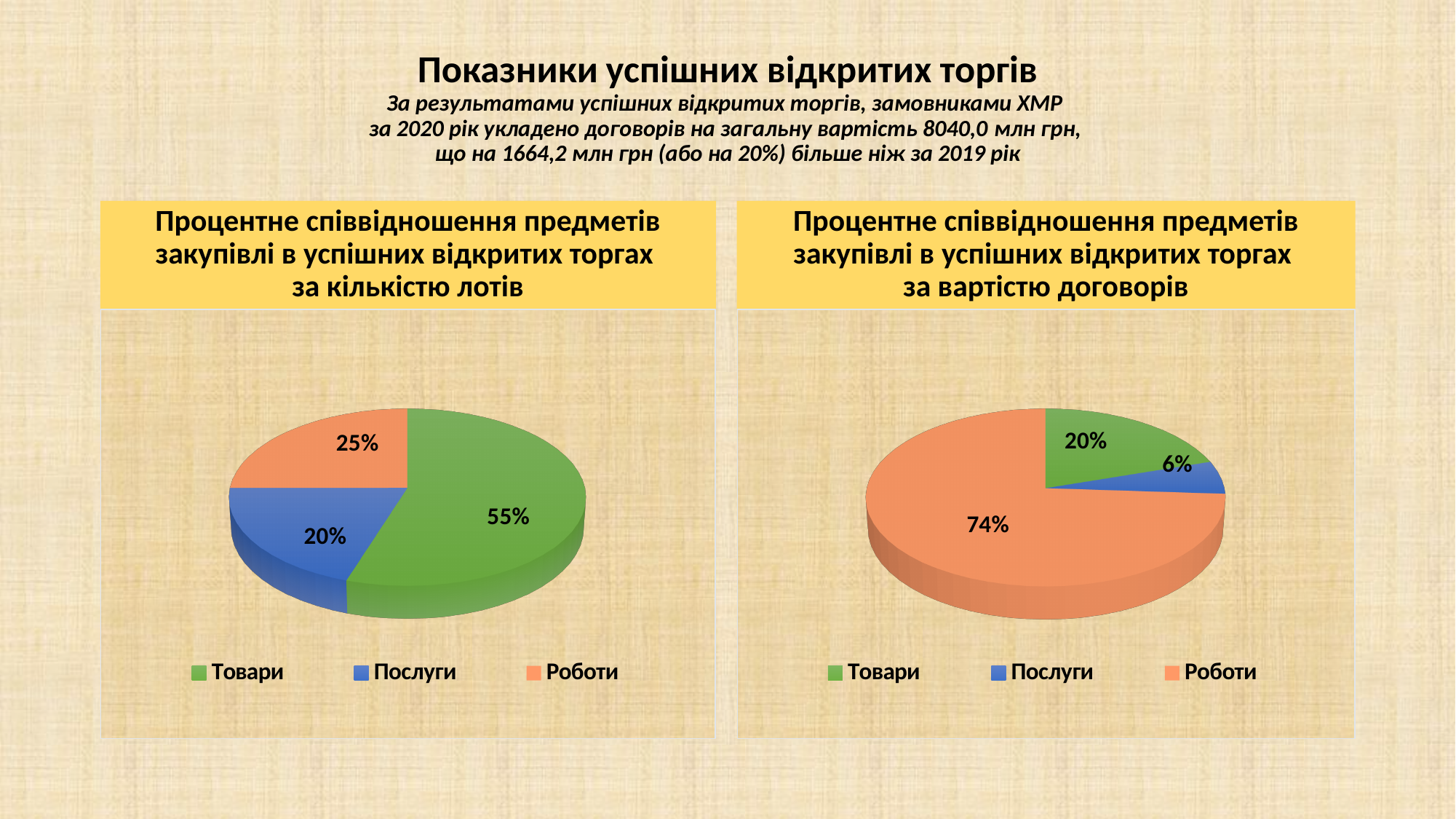
In the right pie chart (by contract value), which category has the smallest share? Послуги In the right pie chart (by contract value), what share does Товари have? 20% In the left pie chart (by number of lots), what share does Послуги have? 20% How many categories does the legend of the left pie chart list? 3 What type of chart is used on the right side of the slide? Pie chart In the left pie chart (by number of lots), what share does Роботи have? 25% In the left pie chart (by number of lots), what share does Товари have? 55% In the right pie chart (by contract value), what share does Послуги have? 6% In the right pie chart (by contract value), which is larger: the share of Товари or the share of Послуги? Товари In the left pie chart (by number of lots), which category has the largest share? Товари In the right pie chart (by contract value), what share does Роботи have? 74% In the left pie chart (by number of lots), what is the difference between the shares of Товари and Роботи? 30%